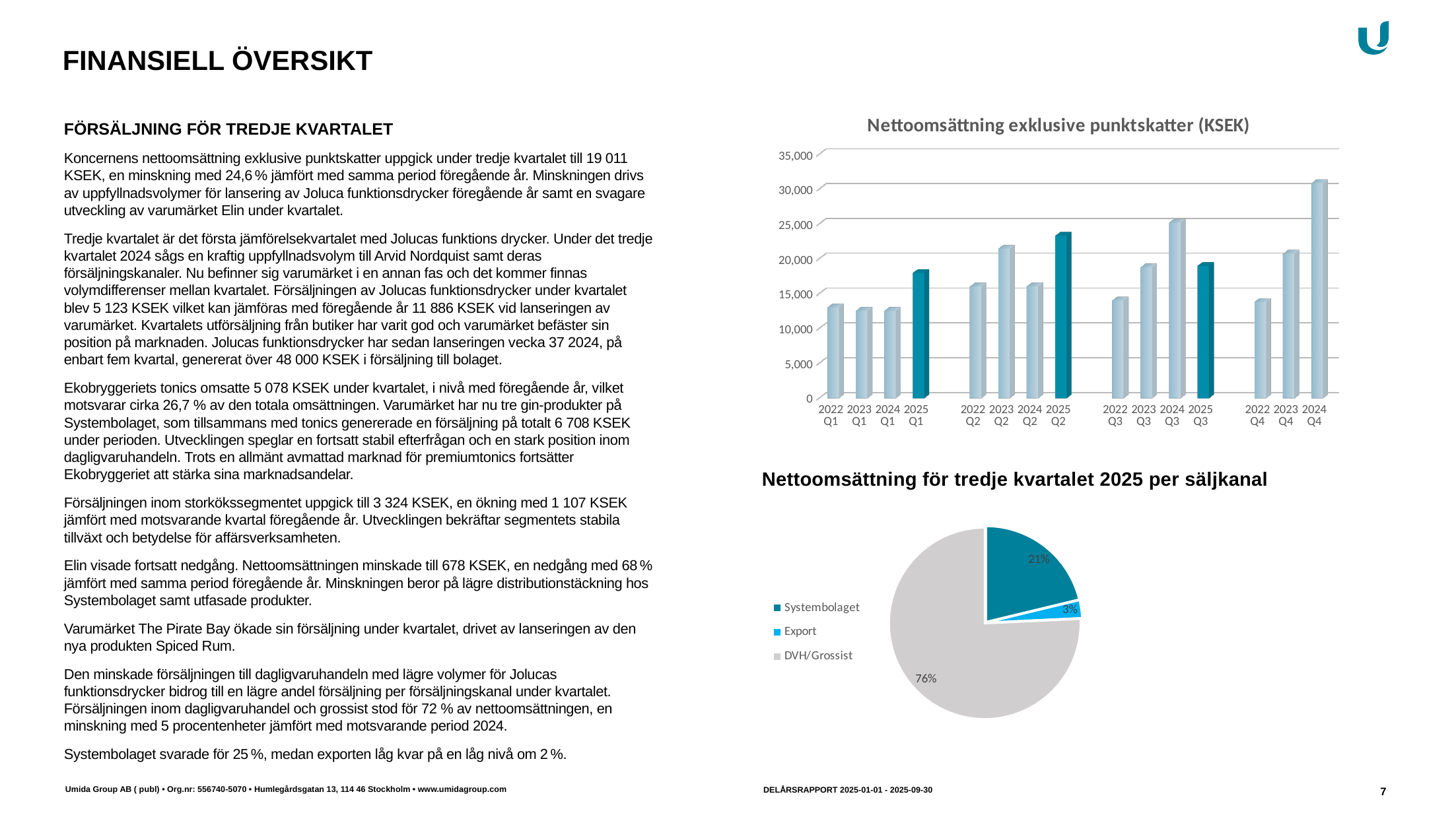
In the pie chart 'Nettoomsättning för tredje kvartalet 2025 per säljkanal', how many entries does the legend list? 3 What kind of chart is the 'Nettoomsättning exklusive punktskatter (KSEK)' chart? bar chart In the 'Nettoomsättning exklusive punktskatter (KSEK)' chart, is the value for 2024 Q4 greater or less than 25,000? greater In the 'Nettoomsättning exklusive punktskatter (KSEK)' chart, is the value for 2025 Q2 greater or less than 20,000? greater In the pie chart 'Nettoomsättning för tredje kvartalet 2025 per säljkanal', what share does Systembolaget have? 21% In the pie chart 'Nettoomsättning för tredje kvartalet 2025 per säljkanal', what share does Export have? 3% In the 'Nettoomsättning exklusive punktskatter (KSEK)' chart, how many bars are plotted? 15 In the 'Nettoomsättning exklusive punktskatter (KSEK)' chart, do the Q1 values rise or fall from 2024 Q1 to 2025 Q1? rise In the pie chart 'Nettoomsättning för tredje kvartalet 2025 per säljkanal', which sales channel has the largest share? DVH/Grossist In the 'Nettoomsättning exklusive punktskatter (KSEK)' chart, is the value for 2025 Q3 greater or less than 20,000? less In the 'Nettoomsättning exklusive punktskatter (KSEK)' chart, which quarter has the highest value? 2024 Q4 In the 'Nettoomsättning exklusive punktskatter (KSEK)' chart, which is larger: 2023 Q4 or 2024 Q4? 2024 Q4